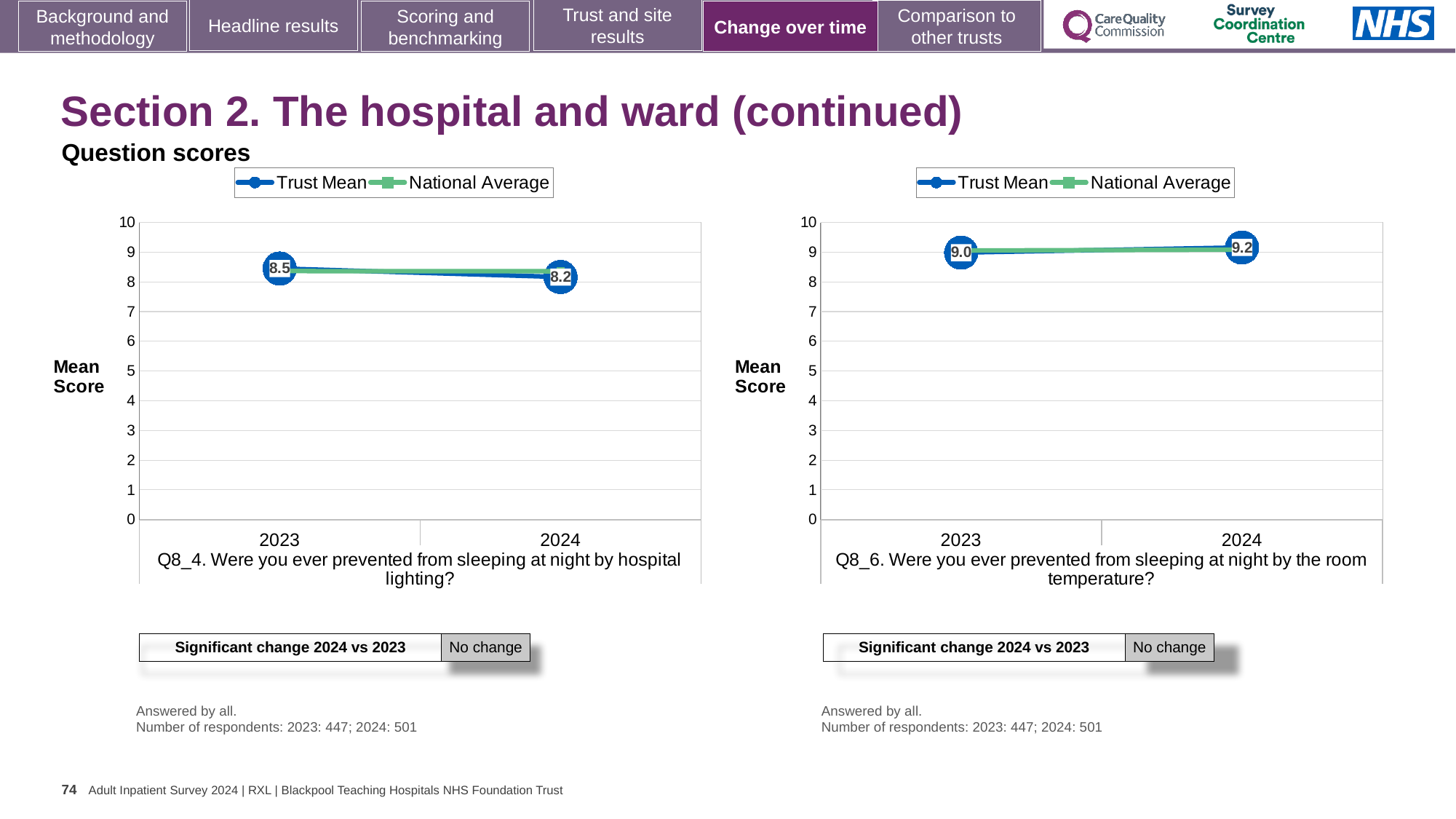
How many series does the legend of the Q8_4 chart (left) list? 2 In the Q8_6 chart (right), what is the Trust Mean score for 2024? 9.2 In the Q8_4 chart (left), what is the Trust Mean score for 2024? 8.2 What type of chart is the Q8_6 chart (right)? line chart In the Q8_6 chart (right), which year has the higher Trust Mean, 2023 or 2024? 2024 In the Q8_6 chart (right), what is the difference between the Trust Mean for 2024 and 2023? 0.2 In the Q8_6 chart (right), does the Trust Mean rise or fall from 2023 to 2024? rise How many years are plotted on the x axis of the Q8_4 chart (left)? 2 In the Q8_4 chart (left), by how much did the Trust Mean change from 2023 to 2024? 0.3 In the Q8_6 chart (right), what is the Trust Mean score for 2023? 9.0 In the Q8_4 chart (left), what is the Trust Mean score for 2023? 8.5 In the Q8_4 chart (left), does the Trust Mean rise or fall from 2023 to 2024? fall